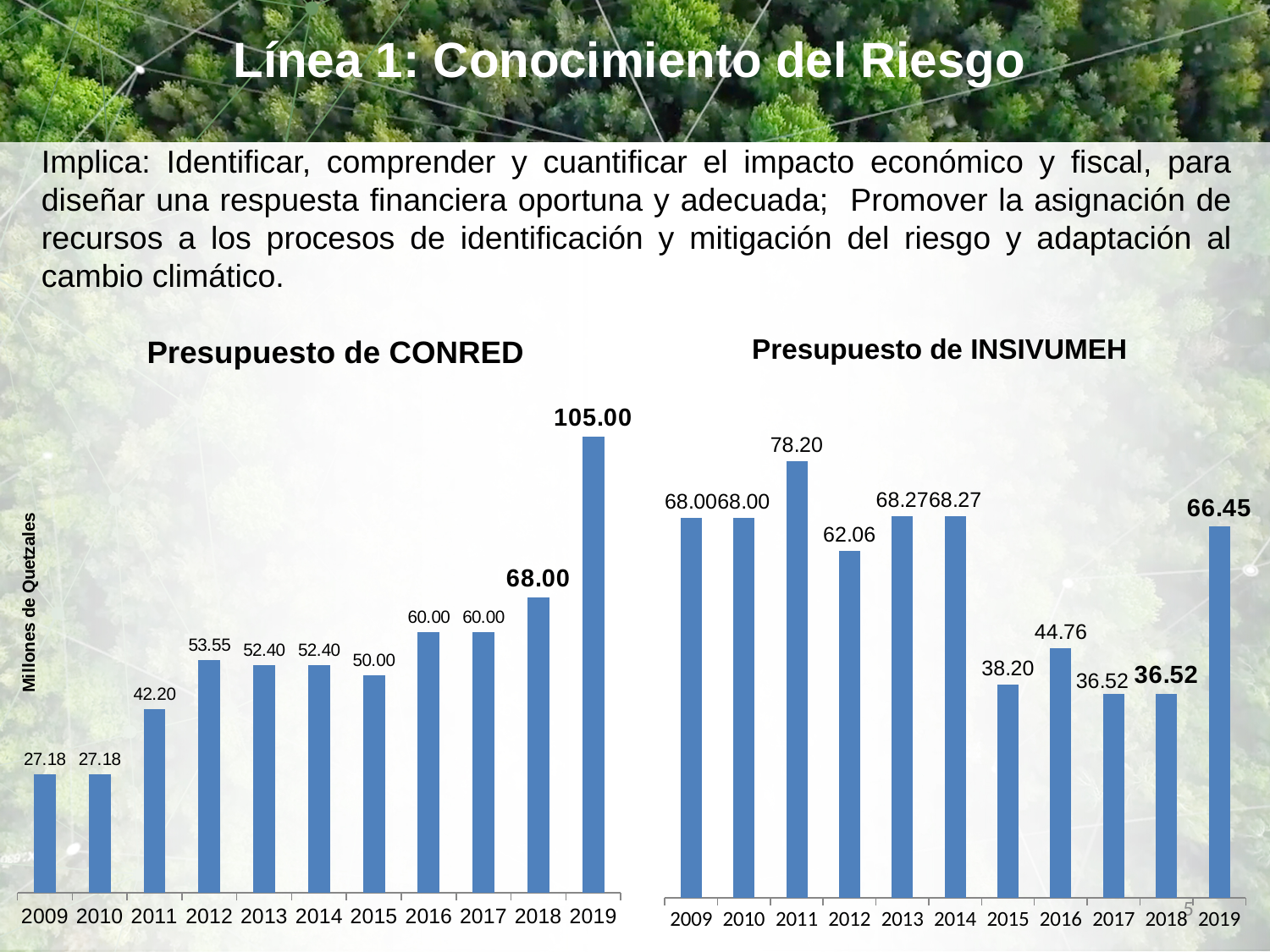
In the 'Presupuesto de CONRED' chart, which year has the lowest value? 2009 and 2010 (27.18) In the 'Presupuesto de INSIVUMEH' chart, which is larger, the value for 2012 or the value for 2019? 2019 What kind of chart is the 'Presupuesto de CONRED' chart? Bar chart In the 'Presupuesto de INSIVUMEH' chart, which year has the highest value? 2011 What is the y-axis label of the 'Presupuesto de CONRED' chart? Millones de Quetzales In the 'Presupuesto de INSIVUMEH' chart, what is the value for 2011? 78.20 In the 'Presupuesto de CONRED' chart, what is the difference between the 2019 value and the 2018 value? 37.00 In the 'Presupuesto de INSIVUMEH' chart, what is the value for 2016? 44.76 In the 'Presupuesto de INSIVUMEH' chart, what is the difference between the 2019 value and the 2018 value? 29.93 In the 'Presupuesto de CONRED' chart, what is the value for 2011? 42.20 In the 'Presupuesto de CONRED' chart, how many years are shown on the x axis? 11 In the 'Presupuesto de CONRED' chart, what is the value for 2019? 105.00